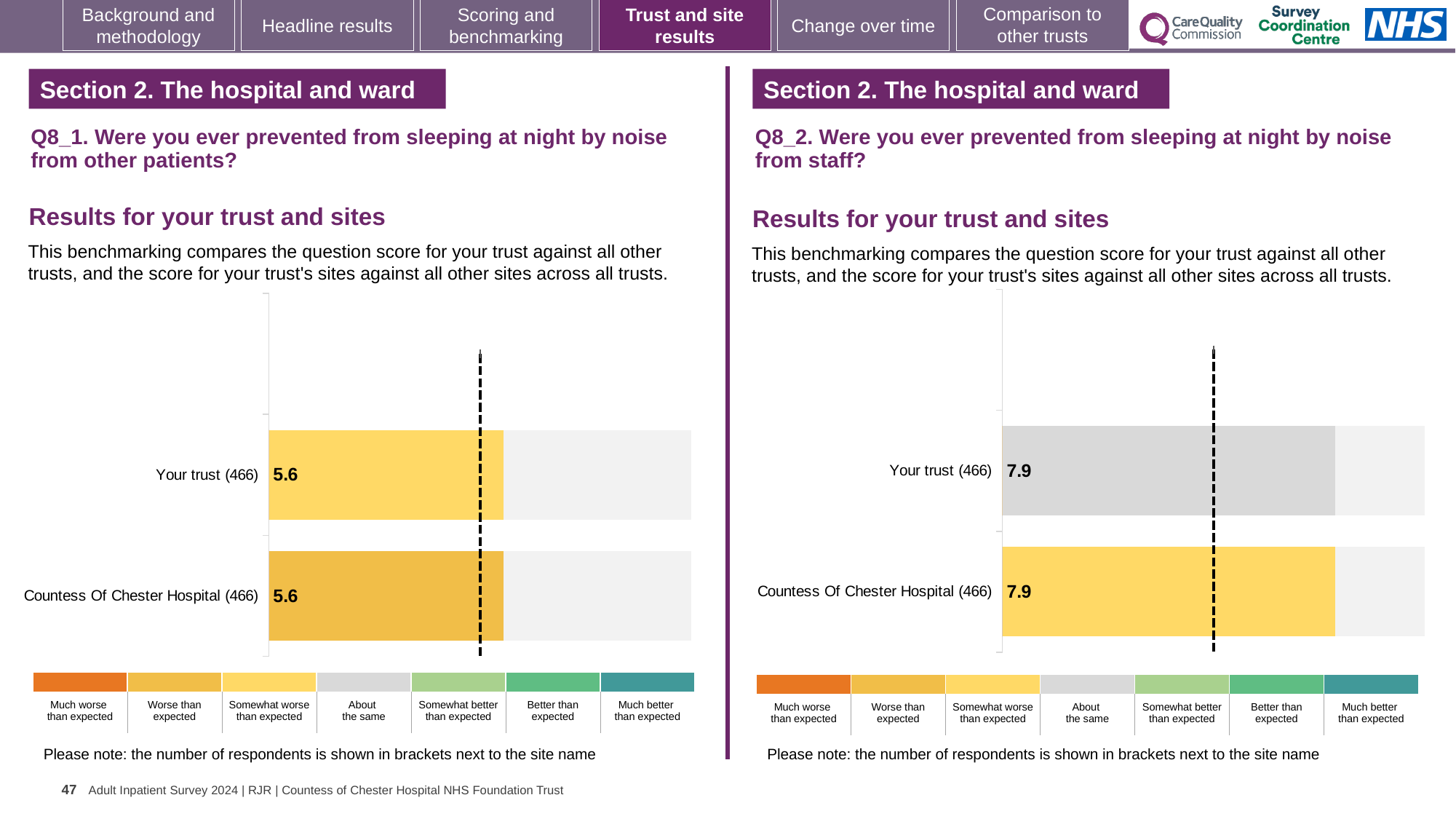
In the Q8_1 chart on the left, what is the score for Countess Of Chester Hospital? 5.6 In the Q8_2 chart on the right, what is the score for Your trust? 7.9 What kind of chart is the Q8_2 chart on the right? Bar chart How many categories does the colour key below the Q8_1 chart on the left list? 7 How many bars are plotted in the Q8_2 chart on the right? 2 In the Q8_1 chart on the left, what is the difference between the score for Your trust and the score for Countess Of Chester Hospital? 0.0 How many bars are plotted in the Q8_1 chart on the left? 2 In the Q8_2 chart on the right, what is the difference between the score for Your trust and the score for Countess Of Chester Hospital? 0.0 In the Q8_1 chart on the left, what is the score for Your trust? 5.6 In the Q8_2 chart on the right, what is the score for Countess Of Chester Hospital? 7.9 In the Q8_2 chart on the right, which benchmark category does the grey colour of the Your trust bar correspond to in the key? About the same In the Q8_1 chart on the left, how many respondents are shown in brackets next to Your trust? 466